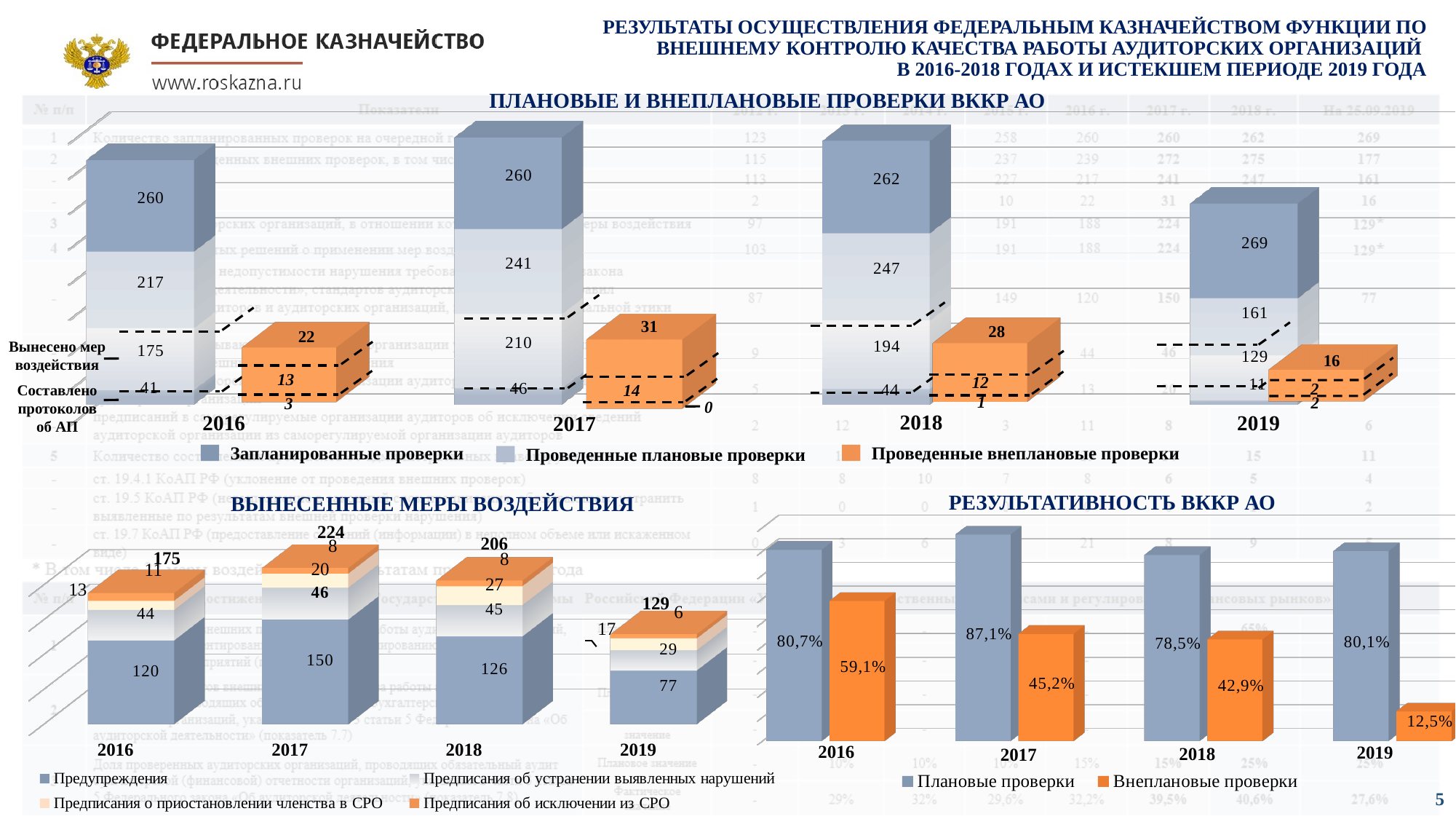
In the chart 'ВЫНЕСЕННЫЕ МЕРЫ ВОЗДЕЙСТВИЯ', what is the value of 'Предупреждения' for 2018? 126 In the chart 'ПЛАНОВЫЕ И ВНЕПЛАНОВЫЕ ПРОВЕРКИ ВККР АО', what is the difference between 'Запланированные проверки' and 'Проведенные плановые проверки' in 2018? 15 In the chart 'ПЛАНОВЫЕ И ВНЕПЛАНОВЫЕ ПРОВЕРКИ ВККР АО', what is the value of 'Запланированные проверки' for 2019? 269 In the chart 'ВЫНЕСЕННЫЕ МЕРЫ ВОЗДЕЙСТВИЯ', what is the total of the stacked bar for 2017? 224 In the chart 'ПЛАНОВЫЕ И ВНЕПЛАНОВЫЕ ПРОВЕРКИ ВККР АО', which year has the lowest value of 'Проведенные плановые проверки'? 2019 In the chart 'ПЛАНОВЫЕ И ВНЕПЛАНОВЫЕ ПРОВЕРКИ ВККР АО', what is the value of 'Проведенные внеплановые проверки' for 2017? 31 In the chart 'ВЫНЕСЕННЫЕ МЕРЫ ВОЗДЕЙСТВИЯ', which year has the highest total? 2017 In the chart 'РЕЗУЛЬТАТИВНОСТЬ ВККР АО', do the values of 'Внеплановые проверки' rise or fall from 2016 to 2019? fall In the chart 'РЕЗУЛЬТАТИВНОСТЬ ВККР АО', which year has the highest value of 'Плановые проверки'? 2017 How many series does the legend of the chart 'ПЛАНОВЫЕ И ВНЕПЛАНОВЫЕ ПРОВЕРКИ ВККР АО' list? 3 In the chart 'ВЫНЕСЕННЫЕ МЕРЫ ВОЗДЕЙСТВИЯ', how many years are shown on the x axis? 4 In the chart 'РЕЗУЛЬТАТИВНОСТЬ ВККР АО', what is the value of 'Внеплановые проверки' for 2019? 12,5%